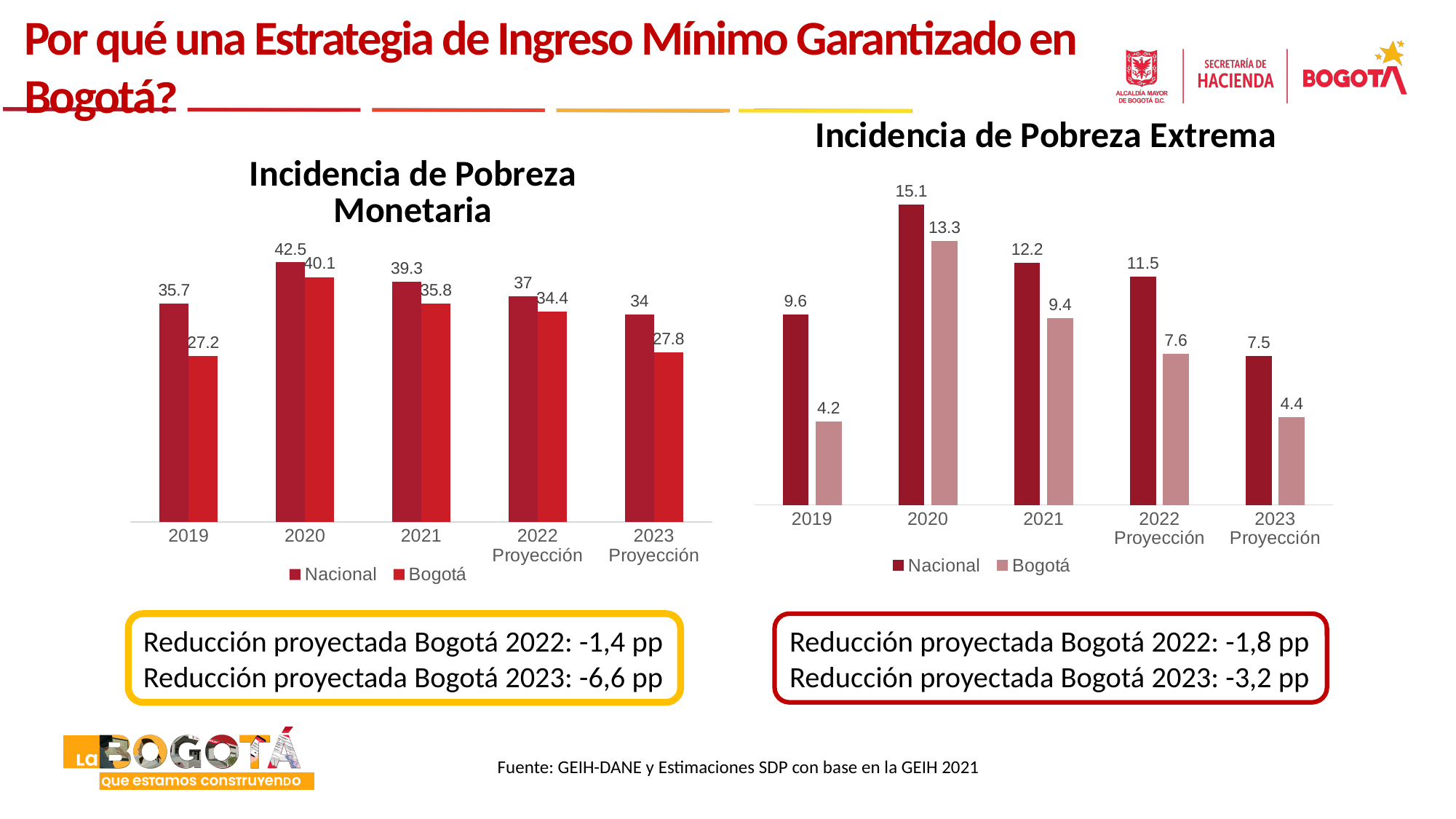
What kind of chart is the 'Incidencia de Pobreza Extrema' chart? Bar chart In the 'Incidencia de Pobreza Monetaria' chart, what is the Bogotá value for 2019? 27.2 In the 'Incidencia de Pobreza Extrema' chart, which year has the lowest Bogotá value? 2019 In the 'Incidencia de Pobreza Monetaria' chart, what is the Nacional value for 2020? 42.5 In the 'Incidencia de Pobreza Extrema' chart, what is the difference between the Nacional values for 2020 and 2021? 2.9 In the 'Incidencia de Pobreza Monetaria' chart, which is larger for 2021: Nacional or Bogotá? Nacional How many series does the legend of the 'Incidencia de Pobreza Monetaria' chart list? 2 In the 'Incidencia de Pobreza Extrema' chart, what is the Bogotá value for 2022 Proyección? 7.6 In the 'Incidencia de Pobreza Monetaria' chart, do the Nacional values rise or fall from 2020 to 2023 Proyección? Fall In the 'Incidencia de Pobreza Monetaria' chart, what is the difference between the Nacional and Bogotá values for 2023 Proyección? 6.2 In the 'Incidencia de Pobreza Extrema' chart, which year has the highest Nacional value? 2020 How many year categories does the 'Incidencia de Pobreza Extrema' chart show? 5